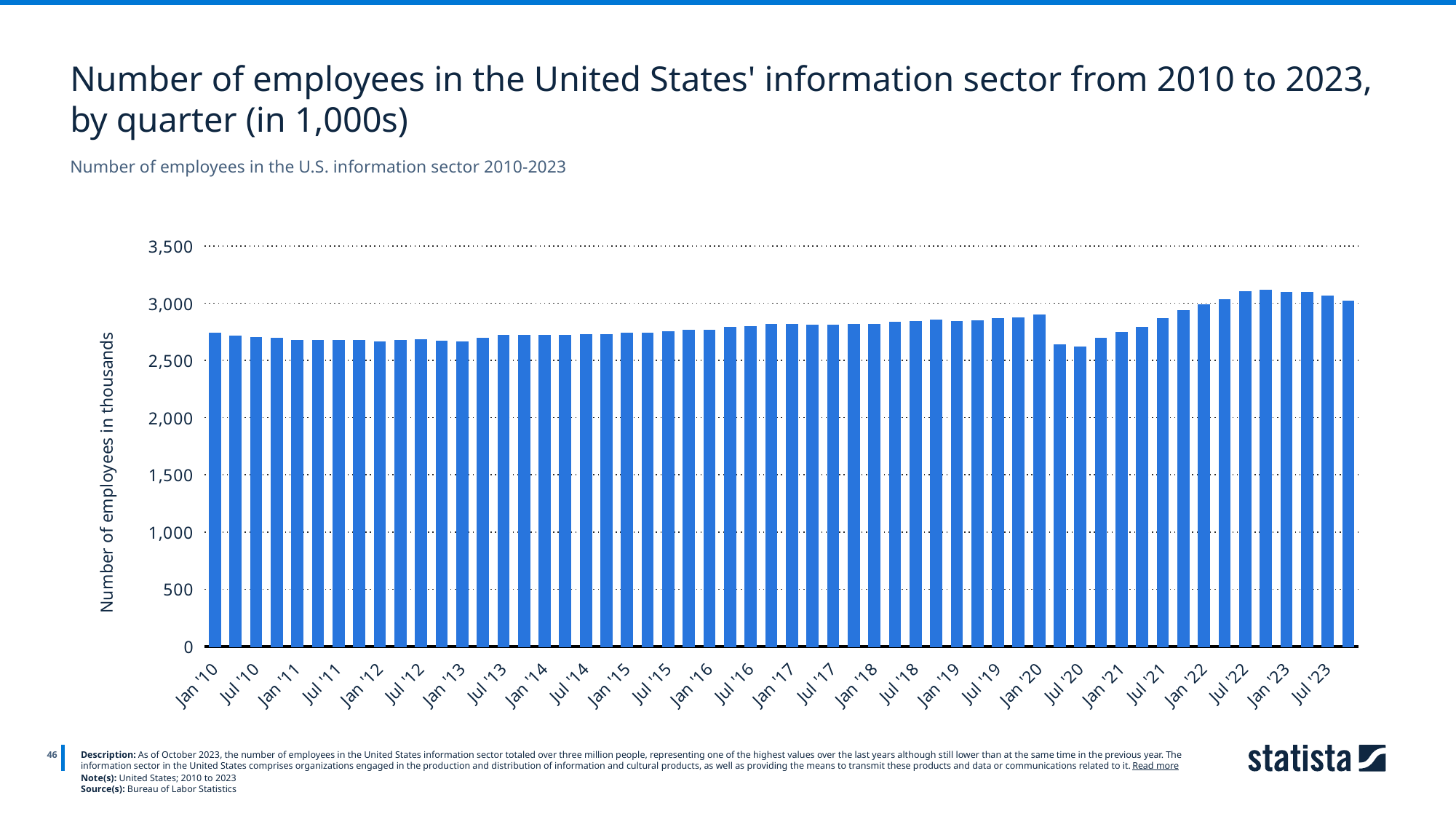
Is the value for Jan '10 greater or less than 2,500? greater Do the values generally rise or fall from Jan '10 to Jul '23 overall? rise Is the value for Jul '22 greater or less than 3,000? greater What is the highest value shown on the y-axis? 3,500 Is the value for Jul '20 greater or less than 3,000? less Which is larger, the value for Jul '20 or the value for Jan '22? Jan '22 Do the values generally rise or fall from Jan '21 to Jul '22? rise What kind of chart is shown on the slide? Bar chart Which is larger, the value for Jul '22 or the value for Jan '10? Jul '22 What is the label of the y-axis? Number of employees in thousands